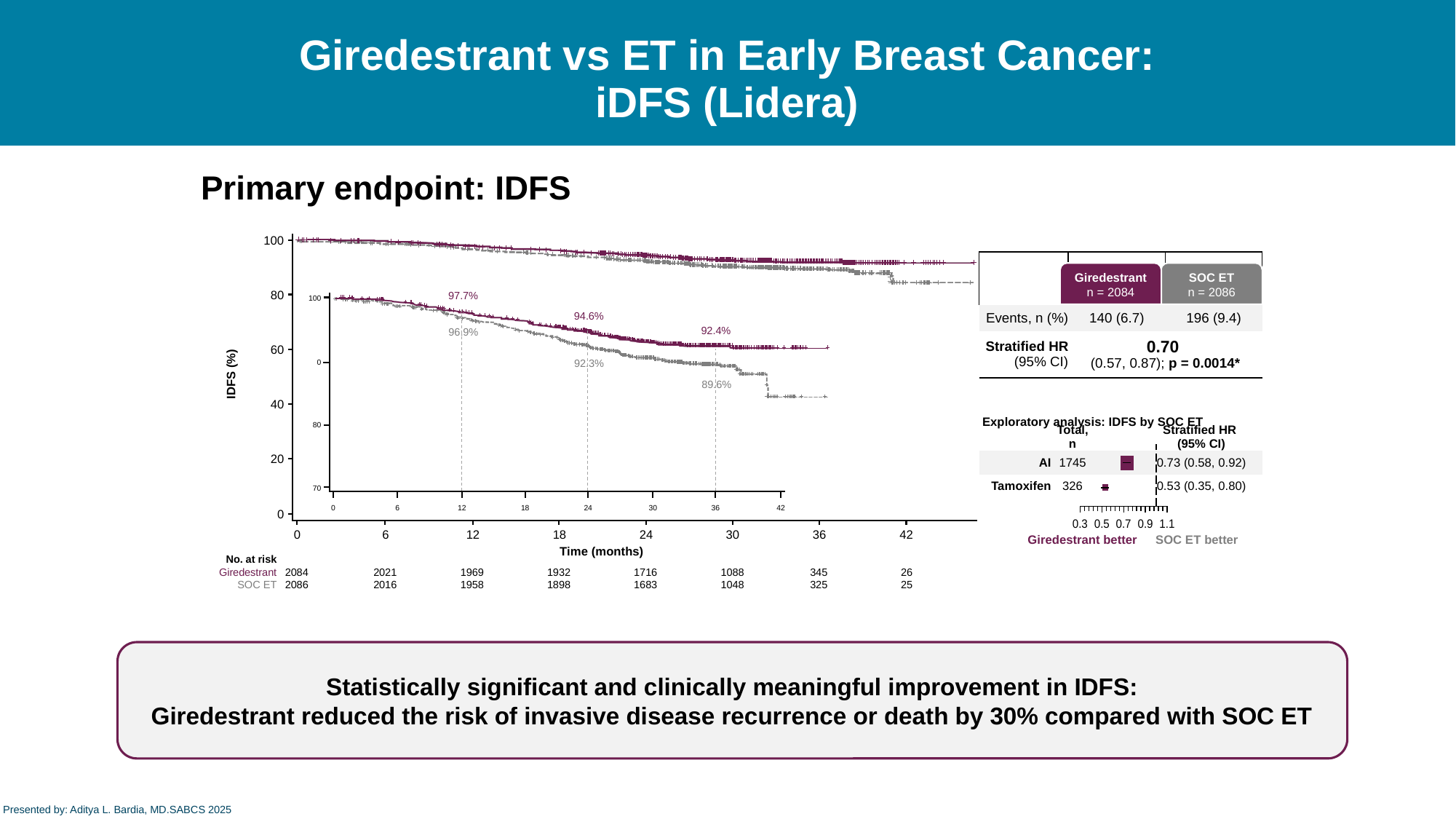
In the Kaplan-Meier chart, do the iDFS curves rise or fall as time in months increases? fall In the Kaplan-Meier chart, what is the labelled iDFS rate for Giredestrant at 12 months? 97.7% In the Kaplan-Meier chart, what is the labelled iDFS rate for SOC ET at 36 months? 89.6% In the exploratory forest plot of IDFS by SOC ET, what is the stratified HR (95% CI) for the AI subgroup? 0.73 (0.58, 0.92) In the Kaplan-Meier chart, what is the difference between the labelled Giredestrant and SOC ET iDFS rates at 36 months? 2.8% In the exploratory forest plot of IDFS by SOC ET, what is the total n for the Tamoxifen subgroup? 326 In the number-at-risk table below the Kaplan-Meier chart, how many SOC ET patients were at risk at 18 months? 1898 In the number-at-risk table below the Kaplan-Meier chart, how many Giredestrant patients were at risk at 30 months? 1088 In the Kaplan-Meier chart, which arm has the higher labelled iDFS rate at 12 months? Giredestrant What kind of chart is the main plot of IDFS (%) against time in months? line chart In the Kaplan-Meier chart, what is the difference between the labelled Giredestrant and SOC ET iDFS rates at 24 months? 2.3% In the Kaplan-Meier chart, what is the labelled iDFS rate for SOC ET at 24 months? 92.3%